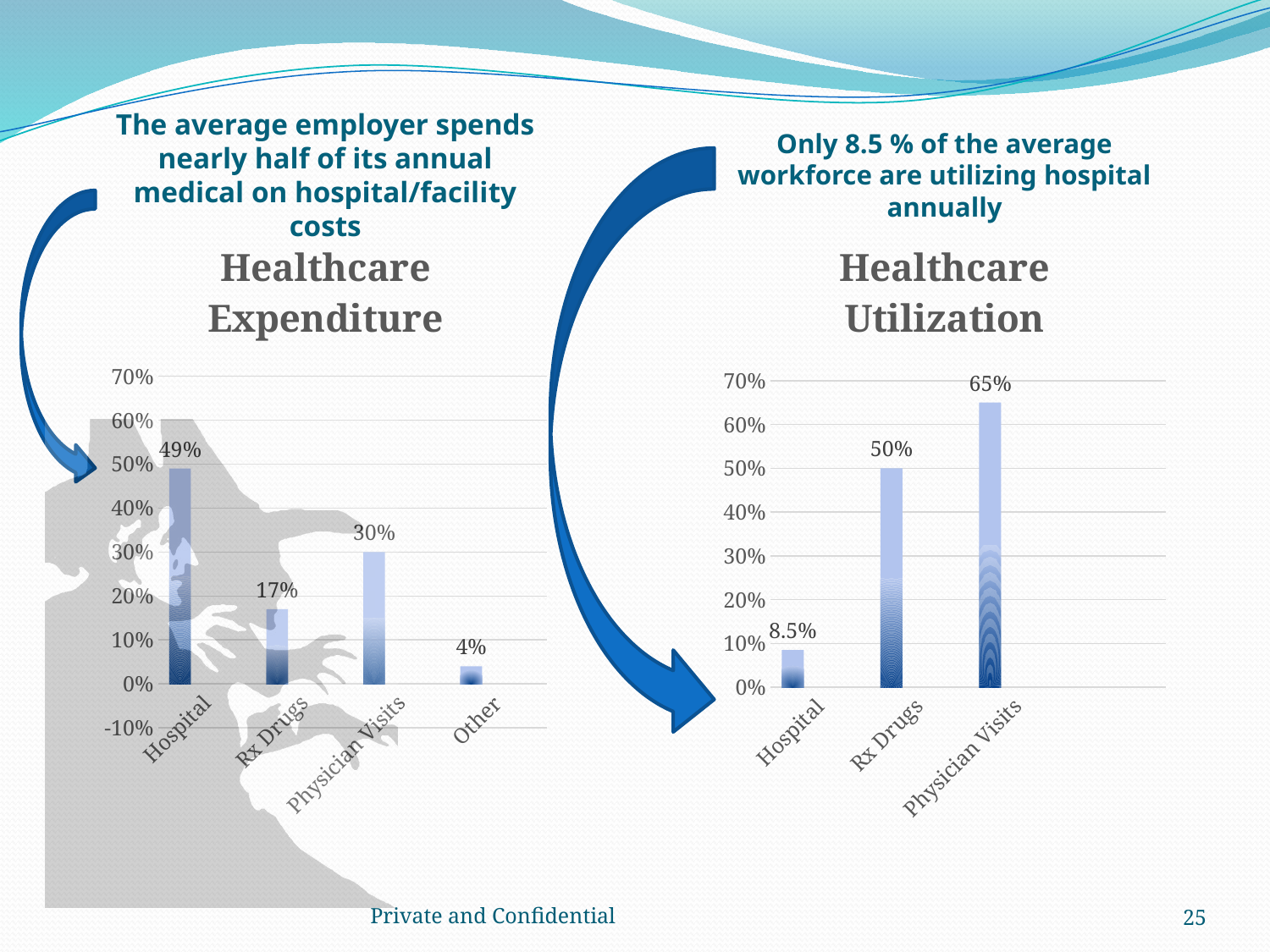
What type of chart is the Healthcare Utilization chart? Bar chart In the Healthcare Expenditure chart, what is the difference between Hospital and Physician Visits? 19% In the Healthcare Utilization chart, what is the value for Physician Visits? 65% In the Healthcare Utilization chart, which category has the highest value? Physician Visits In the Healthcare Expenditure chart, how many categories are shown? 4 In the Healthcare Utilization chart, which is larger, Rx Drugs or Hospital? Rx Drugs In the Healthcare Expenditure chart, what is the value for Rx Drugs? 17% In the Healthcare Utilization chart, what is the value for Hospital? 8.5% In the Healthcare Utilization chart, how many categories are shown? 3 In the Healthcare Expenditure chart, what is the value for Hospital? 49% In the Healthcare Utilization chart, what is the difference between Physician Visits and Rx Drugs? 15% In the Healthcare Expenditure chart, which category has the lowest value? Other